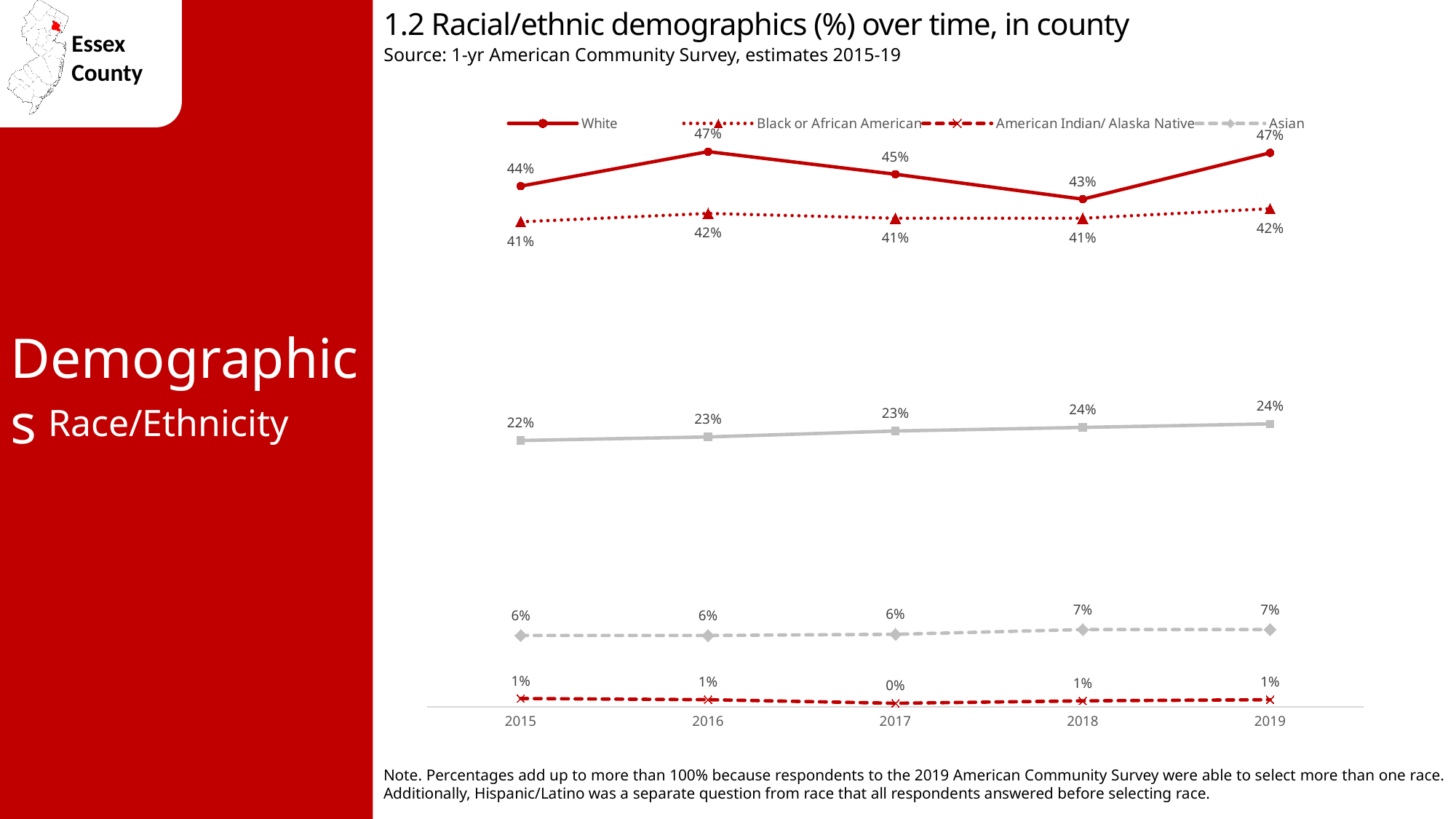
What is the title of the chart? 1.2 Racial/ethnic demographics (%) over time, in county How many series does the legend list? 4 What is the value for American Indian/ Alaska Native in 2017? 0% In which year is the value for White the lowest? 2018 What is the value for Black or African American in 2019? 42% What is the value for White in 2015? 44% Does the value for Asian rise or fall from 2015 to 2019? Rise What is the value for Asian in 2018? 7% What is the difference between the White and Black or African American values in 2016? 5 percentage points What kind of chart is shown on the slide? Line chart Which is larger in 2017, the value for White or the value for Black or African American? White How many years are shown on the x axis? 5